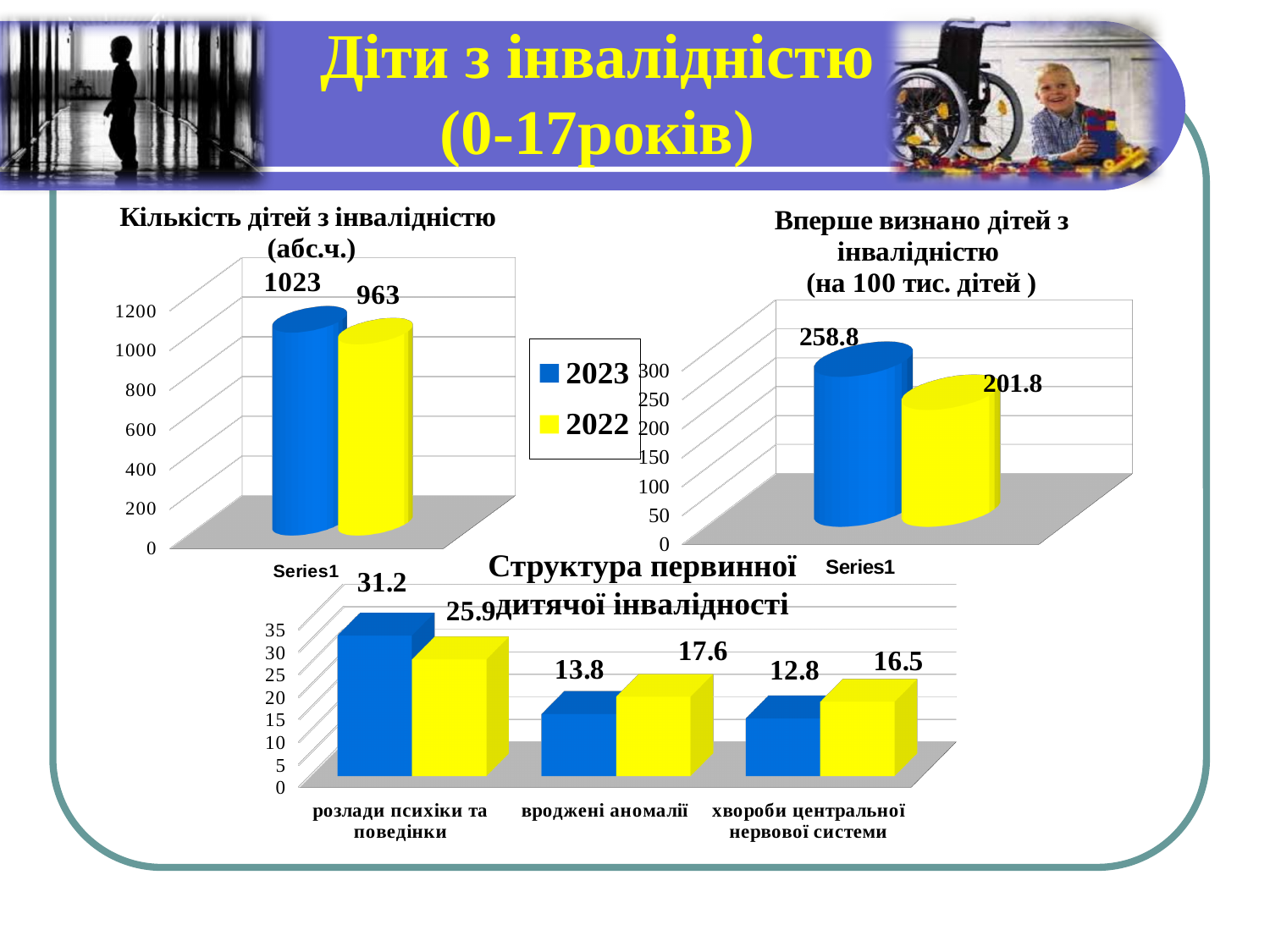
In the chart titled "Вперше визнано дітей з інвалідністю (на 100 тис. дітей)", which bar is larger, the blue (2023) or the yellow (2022)? blue (2023) In the chart titled "Кількість дітей з інвалідністю (абс.ч.)", what is the value of the blue (2023) bar? 1023 In the chart titled "Вперше визнано дітей з інвалідністю (на 100 тис. дітей)", what is the value of the yellow (2022) bar? 201.8 In the chart titled "Кількість дітей з інвалідністю (абс.ч.)", what is the difference between the 2023 and 2022 values? 60 In the chart titled "Вперше визнано дітей з інвалідністю (на 100 тис. дітей)", what is the value of the blue (2023) bar? 258.8 In the chart titled "Структура первинної дитячої інвалідності", which category has the highest blue bar? розлади психіки та поведінки In the chart titled "Структура первинної дитячої інвалідності", what is the value of the blue bar for "хвороби центральної нервової системи"? 12.8 In the chart titled "Структура первинної дитячої інвалідності", how many categories are shown on the x axis? 3 In the chart titled "Кількість дітей з інвалідністю (абс.ч.)", what is the value of the yellow (2022) bar? 963 What kind of chart is the chart titled "Структура первинної дитячої інвалідності"? bar chart In the chart titled "Структура первинної дитячої інвалідності", what is the value of the yellow bar for "вроджені аномалії"? 17.6 In the chart titled "Структура первинної дитячої інвалідності", what is the value of the blue bar for "розлади психіки та поведінки"? 31.2